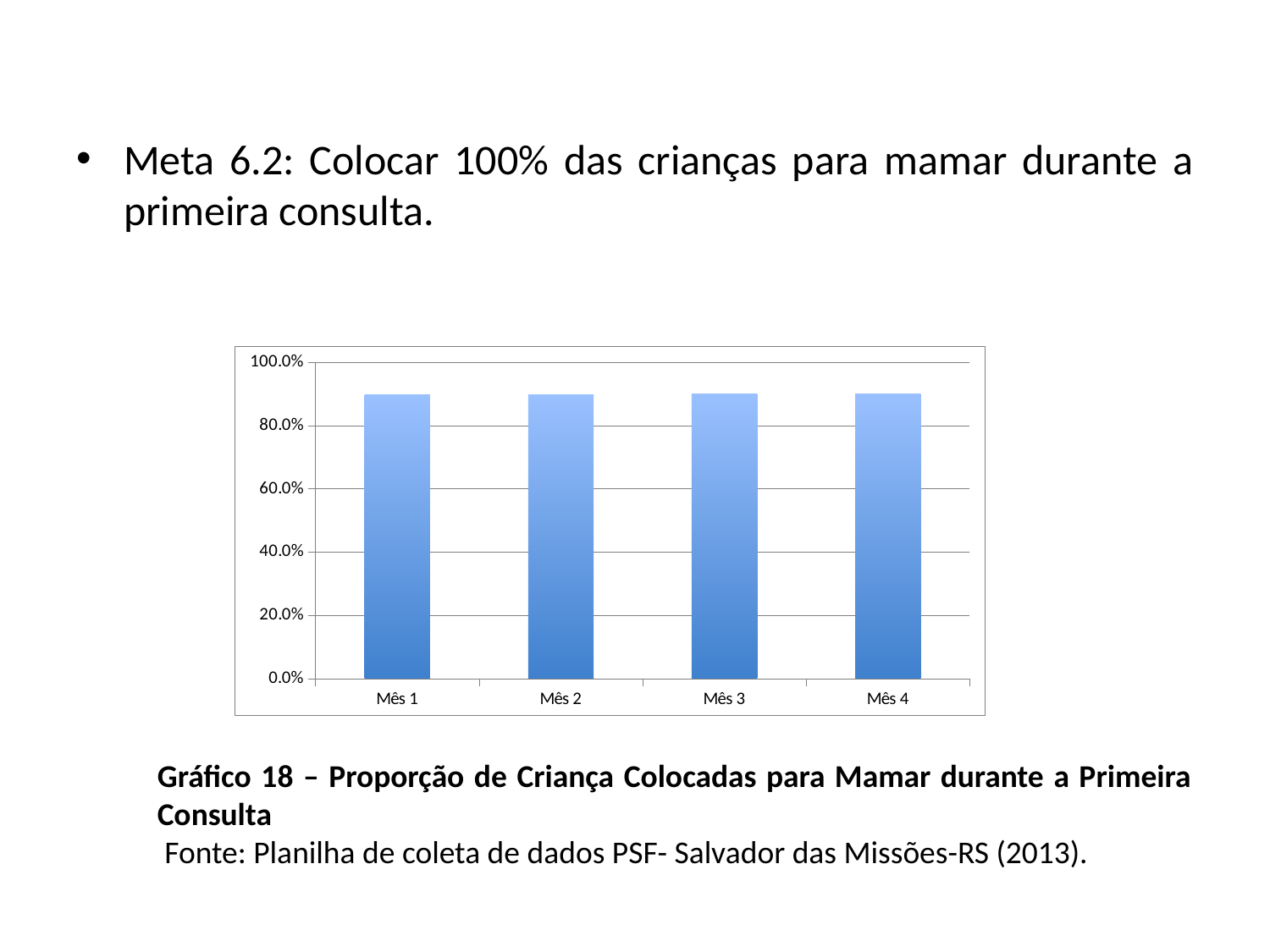
Is the value for Mês 1 greater or less than 80.0%? greater Do the values rise, fall, or stay roughly the same from Mês 1 to Mês 4? stay roughly the same What is the label of the first category on the x axis? Mês 1 What is the highest value shown on the y axis of the chart? 100.0% How many categories (months) are shown on the x axis of the chart? 4 Is the value for Mês 4 greater or less than 80.0%? greater Is the value for Mês 2 greater or less than 100.0%? less What kind of chart is shown on the slide? bar chart